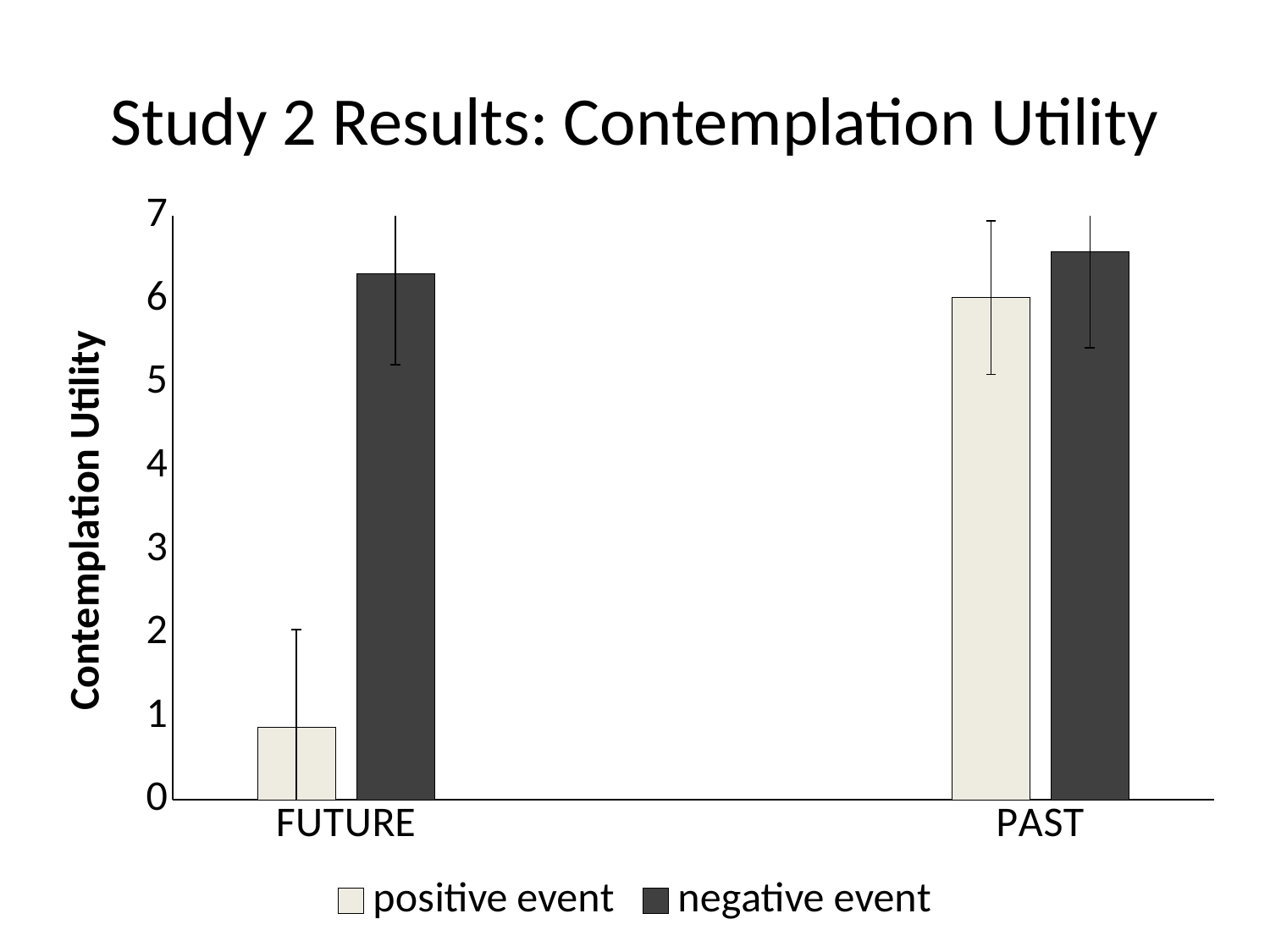
Which category and series combination has the lowest contemplation utility? FUTURE, positive event How many categories are shown on the x axis? 2 Does the positive event series rise or fall from FUTURE to PAST? rise What kind of chart is shown on the slide? bar chart Is the value for the negative event in the PAST category greater or less than 6? greater Is the value for the positive event in the FUTURE category greater or less than 2? less How many series does the legend list? 2 What is the title of the chart? Study 2 Results: Contemplation Utility Is the value for the positive event in the PAST category greater or less than 5? greater For FUTURE, which is larger: the positive event bar or the negative event bar? negative event What is the label on the y axis? Contemplation Utility